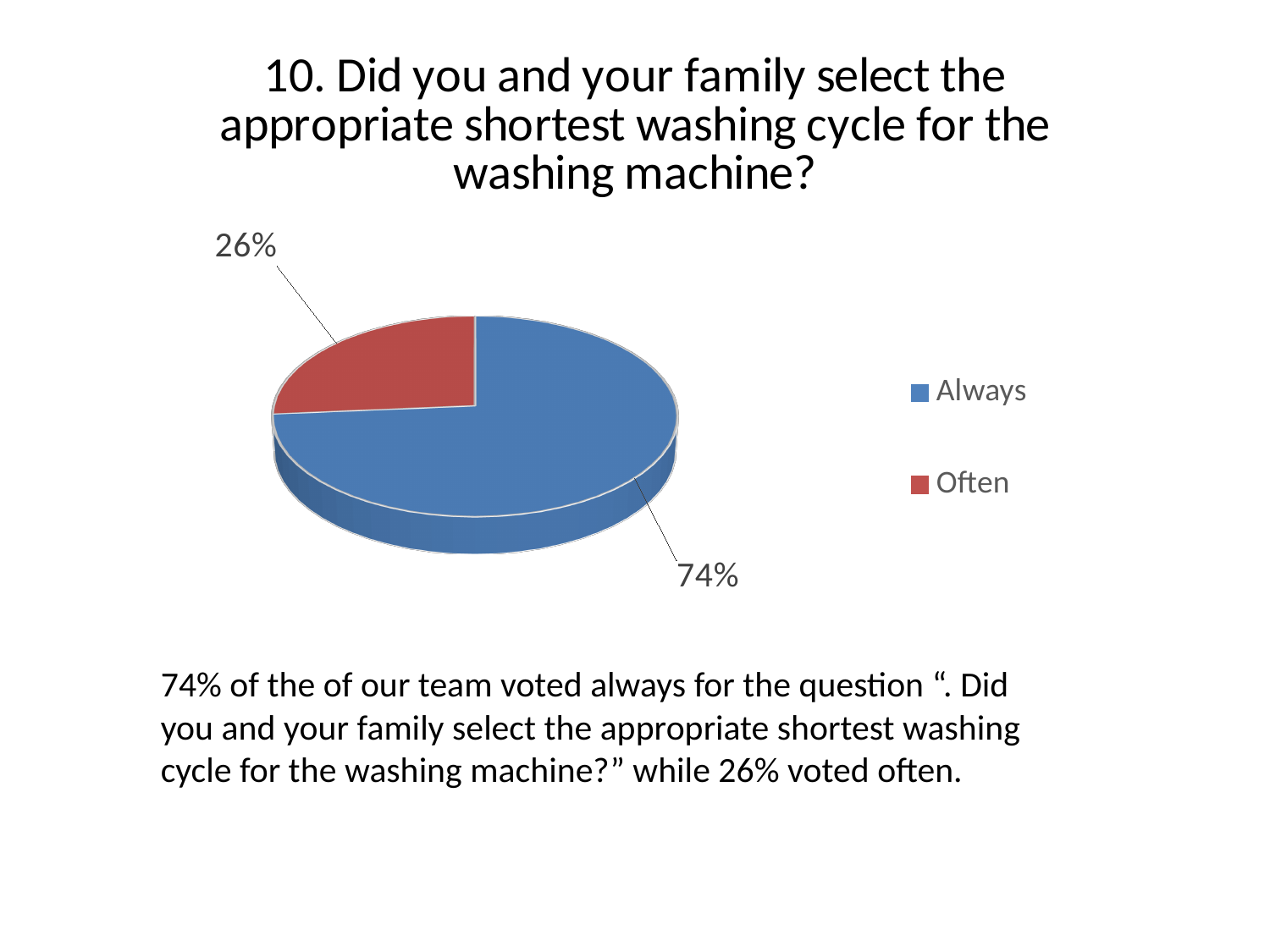
What is the difference in percentage points between the Always and Often slices? 48 What share of the pie does the Always slice represent? 74% Which category has the smallest slice of the pie? Often What kind of chart is shown on the slide? Pie chart Which category has the largest slice of the pie? Always What colour is the Always slice in the pie chart? Blue Which is larger, the Always slice or the Often slice? Always How many slices does the pie chart have? 2 What colour is the Often slice in the pie chart? Red What share of the pie does the Often slice represent? 26% How many entries does the legend list? 2 What is the total of the two slice percentages shown on the pie chart? 100%